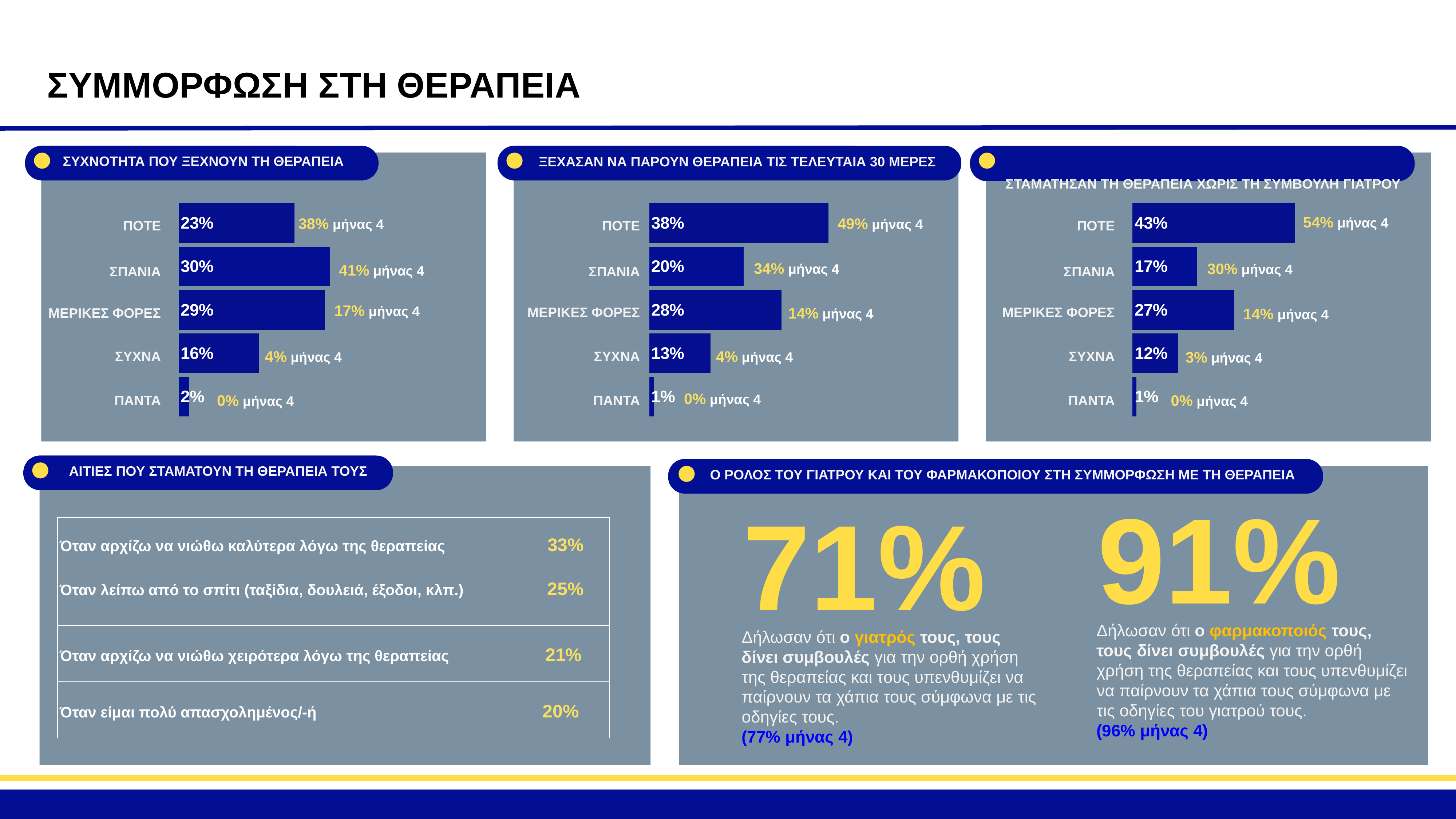
In the top-middle chart (ΞΕΧΑΣΑΝ ΝΑ ΠΑΡΟΥΝ ΘΕΡΑΠΕΙΑ ΤΙΣ ΤΕΛΕΥΤΑΙΑ 30 ΜΕΡΕΣ), which is larger, ΠΟΤΕ or ΣΠΑΝΙΑ? ΠΟΤΕ In the top-right chart (ΣΤΑΜΑΤΗΣΑΝ ΤΗ ΘΕΡΑΠΕΙΑ ΧΩΡΙΣ ΤΗ ΣΥΜΒΟΥΛΗ ΓΙΑΤΡΟΥ), what is the value for ΠΟΤΕ? 43% In the top-middle chart (ΞΕΧΑΣΑΝ ΝΑ ΠΑΡΟΥΝ ΘΕΡΑΠΕΙΑ ΤΙΣ ΤΕΛΕΥΤΑΙΑ 30 ΜΕΡΕΣ), what is the difference between ΠΟΤΕ and ΣΥΧΝΑ? 25% In the top-left chart (ΣΥΧΝΟΤΗΤΑ ΠΟΥ ΞΕΧΝΟΥΝ ΤΗ ΘΕΡΑΠΕΙΑ), what is the value for ΣΠΑΝΙΑ? 30% In the top-left chart (ΣΥΧΝΟΤΗΤΑ ΠΟΥ ΞΕΧΝΟΥΝ ΤΗ ΘΕΡΑΠΕΙΑ), how many categories are shown? 5 In the top-left chart (ΣΥΧΝΟΤΗΤΑ ΠΟΥ ΞΕΧΝΟΥΝ ΤΗ ΘΕΡΑΠΕΙΑ), which category has the highest value? ΣΠΑΝΙΑ In the top-right chart (ΣΤΑΜΑΤΗΣΑΝ ΤΗ ΘΕΡΑΠΕΙΑ ΧΩΡΙΣ ΤΗ ΣΥΜΒΟΥΛΗ ΓΙΑΤΡΟΥ), which is larger, ΣΠΑΝΙΑ or ΜΕΡΙΚΕΣ ΦΟΡΕΣ? ΜΕΡΙΚΕΣ ΦΟΡΕΣ In the top-middle chart (ΞΕΧΑΣΑΝ ΝΑ ΠΑΡΟΥΝ ΘΕΡΑΠΕΙΑ ΤΙΣ ΤΕΛΕΥΤΑΙΑ 30 ΜΕΡΕΣ), what is the value for ΜΕΡΙΚΕΣ ΦΟΡΕΣ? 28% What type of chart is the top-right chart (ΣΤΑΜΑΤΗΣΑΝ ΤΗ ΘΕΡΑΠΕΙΑ ΧΩΡΙΣ ΤΗ ΣΥΜΒΟΥΛΗ ΓΙΑΤΡΟΥ)? Bar chart In the top-right chart (ΣΤΑΜΑΤΗΣΑΝ ΤΗ ΘΕΡΑΠΕΙΑ ΧΩΡΙΣ ΤΗ ΣΥΜΒΟΥΛΗ ΓΙΑΤΡΟΥ), what is the month 4 value shown next to ΠΟΤΕ? 54% In the top-left chart (ΣΥΧΝΟΤΗΤΑ ΠΟΥ ΞΕΧΝΟΥΝ ΤΗ ΘΕΡΑΠΕΙΑ), what is the difference between ΣΥΧΝΑ and ΠΑΝΤΑ? 14% In the top-middle chart (ΞΕΧΑΣΑΝ ΝΑ ΠΑΡΟΥΝ ΘΕΡΑΠΕΙΑ ΤΙΣ ΤΕΛΕΥΤΑΙΑ 30 ΜΕΡΕΣ), which category has the lowest value? ΠΑΝΤΑ